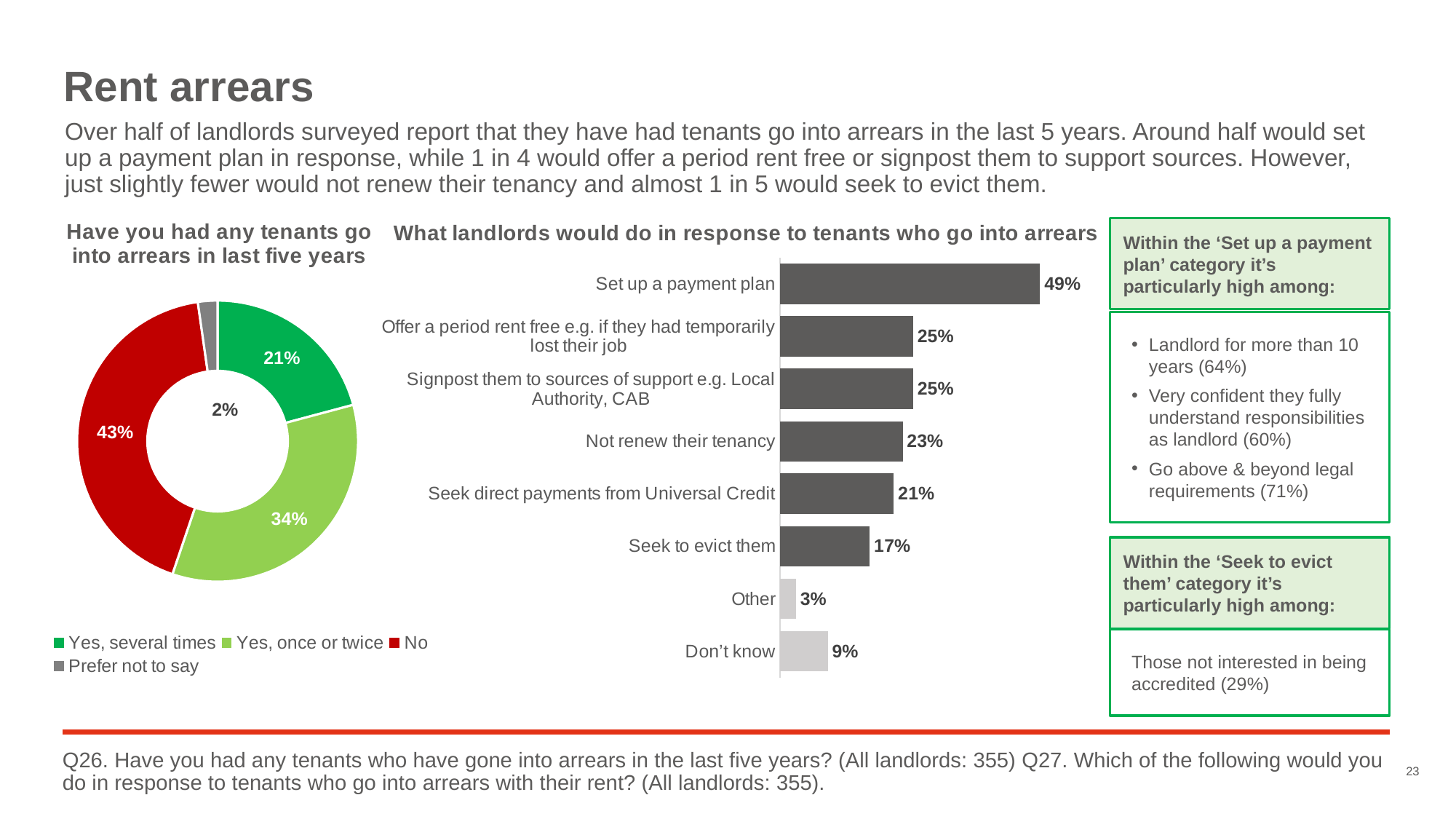
In the 'Have you had any tenants go into arrears in last five years' chart, what share of landlords answered 'No'? 43% In the 'What landlords would do in response to tenants who go into arrears' chart, which is larger: 'Seek direct payments from Universal Credit' or 'Don't know'? Seek direct payments from Universal Credit In the 'What landlords would do in response to tenants who go into arrears' chart, what is the value for 'Seek to evict them'? 17% In the 'What landlords would do in response to tenants who go into arrears' chart, which category has the lowest value? Other In the 'Have you had any tenants go into arrears in last five years' chart, which category has the smallest share? Prefer not to say In the 'Have you had any tenants go into arrears in last five years' chart, how many categories does the legend list? 4 What kind of chart is 'What landlords would do in response to tenants who go into arrears'? Bar chart What kind of chart is 'Have you had any tenants go into arrears in last five years'? Pie (doughnut) chart How many categories are shown in the 'What landlords would do in response to tenants who go into arrears' chart? 8 In the 'What landlords would do in response to tenants who go into arrears' chart, what is the value for 'Set up a payment plan'? 49% In the 'Have you had any tenants go into arrears in last five years' chart, what share answered 'Yes, once or twice'? 34% In the 'What landlords would do in response to tenants who go into arrears' chart, what is the difference between 'Set up a payment plan' and 'Not renew their tenancy'? 26 percentage points